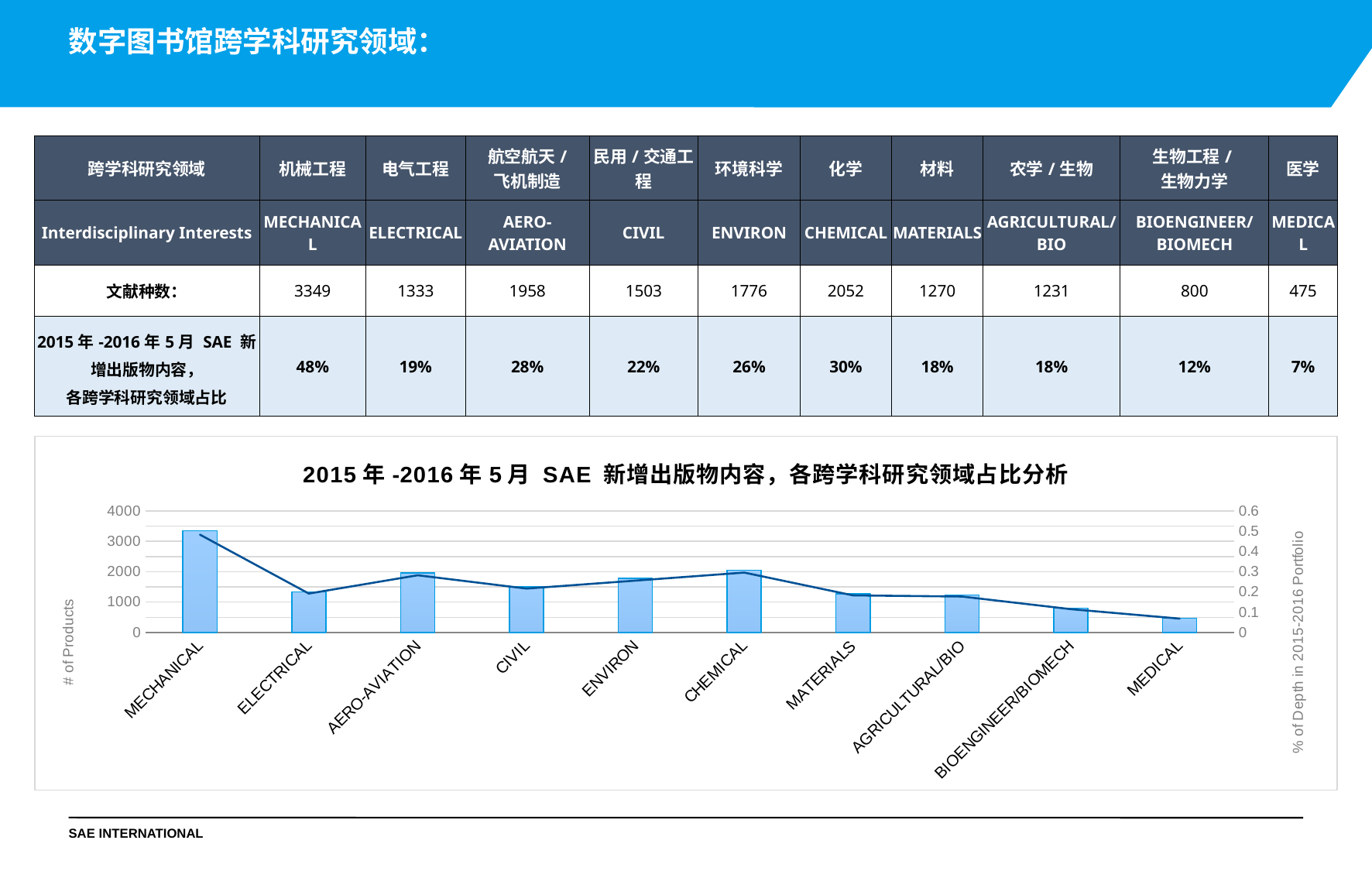
Is the bar value for MECHANICAL greater or less than 3000? greater Which category has the tallest bar in the chart? MECHANICAL Is the line value (right axis) for MECHANICAL greater or less than 0.4? greater What is the label of the right vertical axis of the chart? % of Depth in 2015-2016 Portfolio How many interdisciplinary categories are plotted along the x axis of the chart? 10 Which has the taller bar, ENVIRON or CIVIL? ENVIRON Which category has the shortest bar in the chart? MEDICAL What is the label of the left vertical axis of the chart? # of Products Do the bar values rise or fall from CHEMICAL to MEDICAL along the x axis? fall Is the bar value for ENVIRON greater or less than 2000? less What type of chart is shown on the slide? Combined bar and line chart